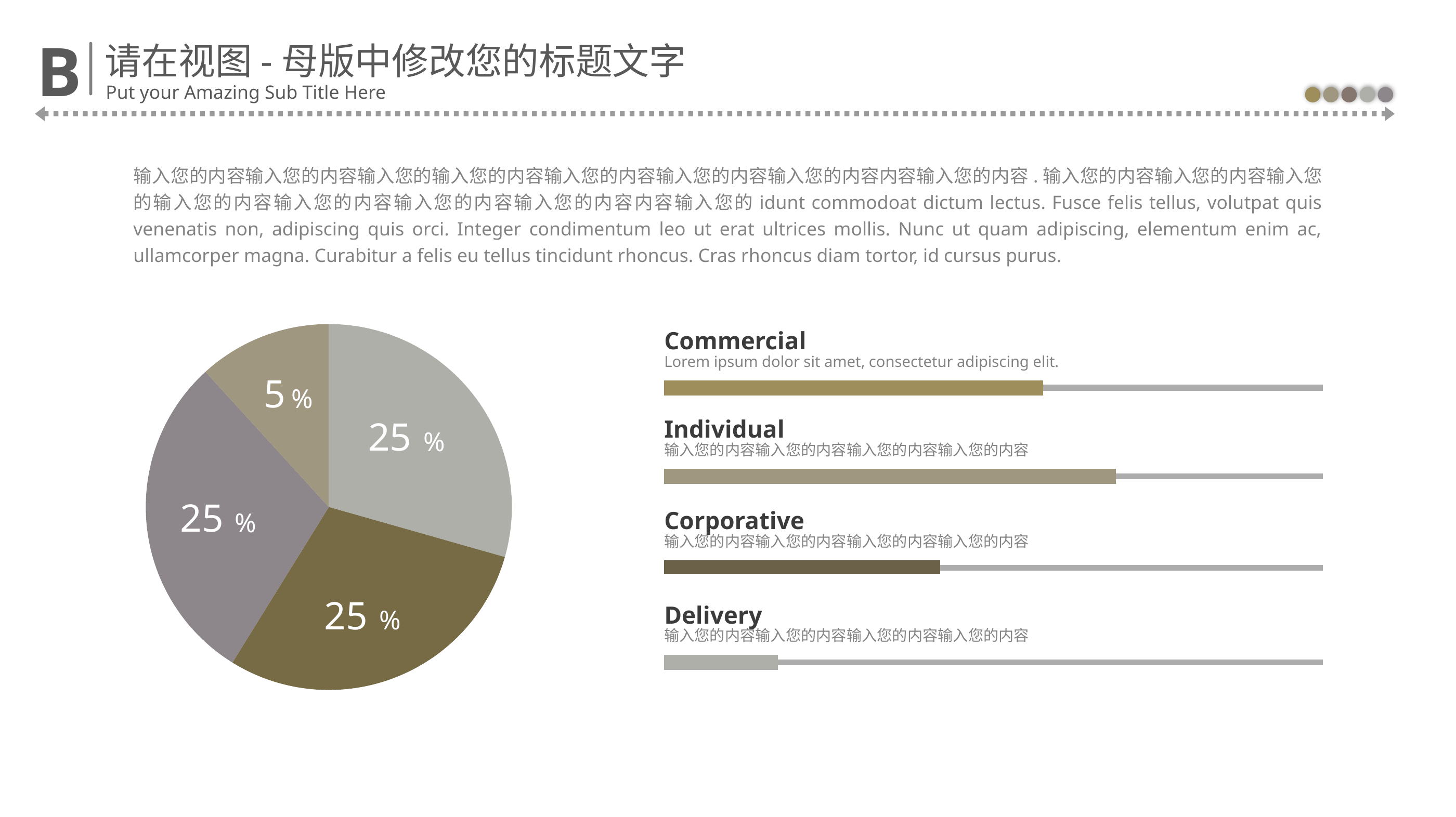
What kind of chart is shown on the left of the slide? pie chart What percentage is labelled on the light grey slice on the right of the pie chart? 25% What percentage is labelled on the small tan slice at the top left of the pie chart? 5% What is the smallest percentage labelled on the pie chart? 5% What percentage is labelled on the dark olive slice at the bottom of the pie chart? 25% How many slices does the pie chart have? 4 What is the difference between the largest labelled slice (25%) and the smallest labelled slice (5%) in the pie chart? 20% Which is larger in the pie chart: the tan slice labelled 5% or the dark olive slice labelled 25%? the dark olive slice (25%) How many slices of the pie chart are labelled 25%? 3 Does the pie chart have a legend? No